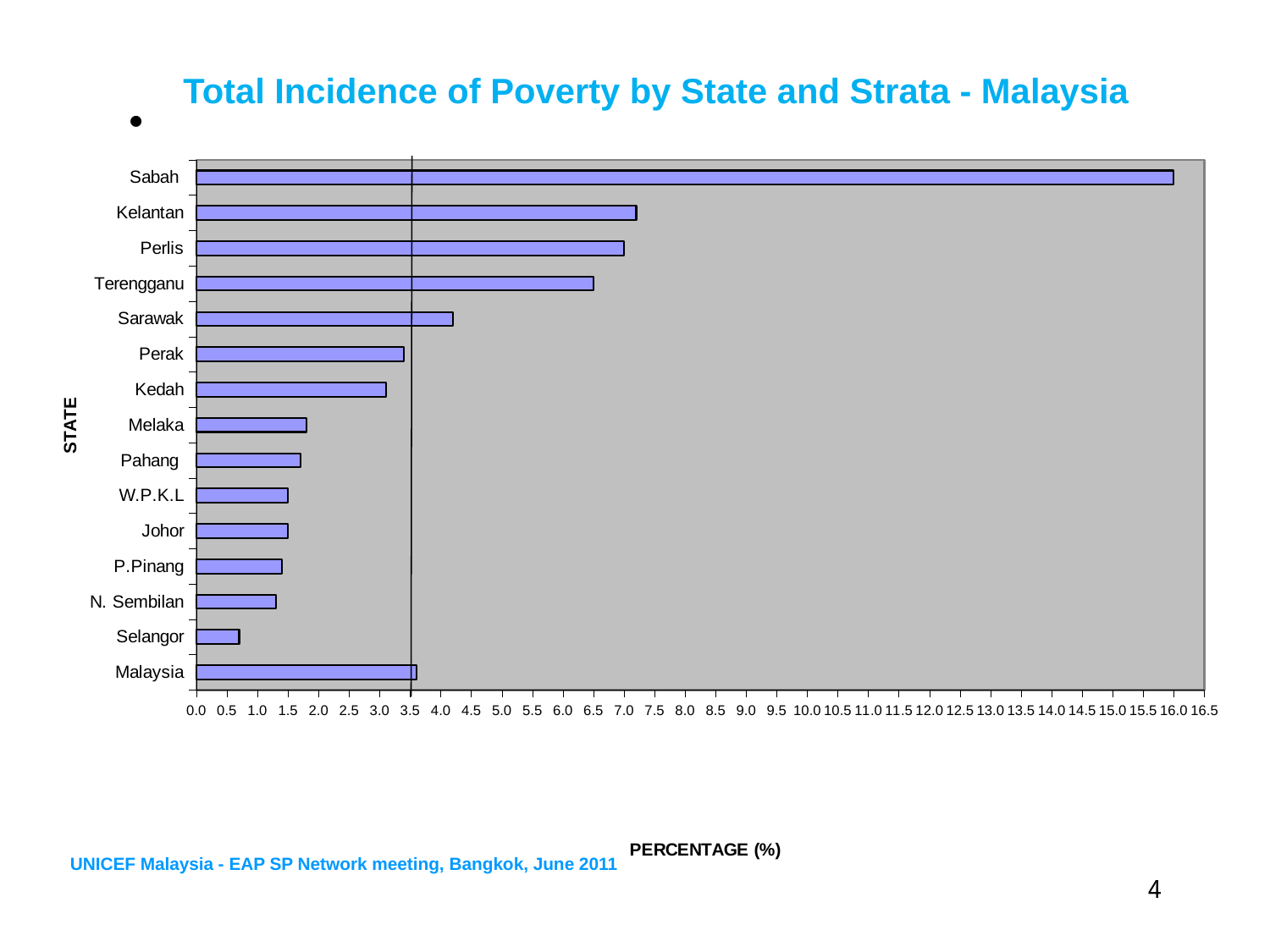
Which has a higher incidence of poverty, Kelantan or Sarawak? Kelantan Is the value for Kedah greater or less than 3.5? less Is the value for Sarawak greater or less than 4.0? greater Is the value for Sabah greater or less than 15.0? greater What kind of chart is shown on the slide? bar chart Which has a higher incidence of poverty, Terengganu or Perak? Terengganu Which state has the lowest incidence of poverty in the chart? Selangor Which state has the highest incidence of poverty in the chart? Sabah How many categories are plotted on the y axis of the chart? 15 What is the label of the x axis of the chart? PERCENTAGE (%)